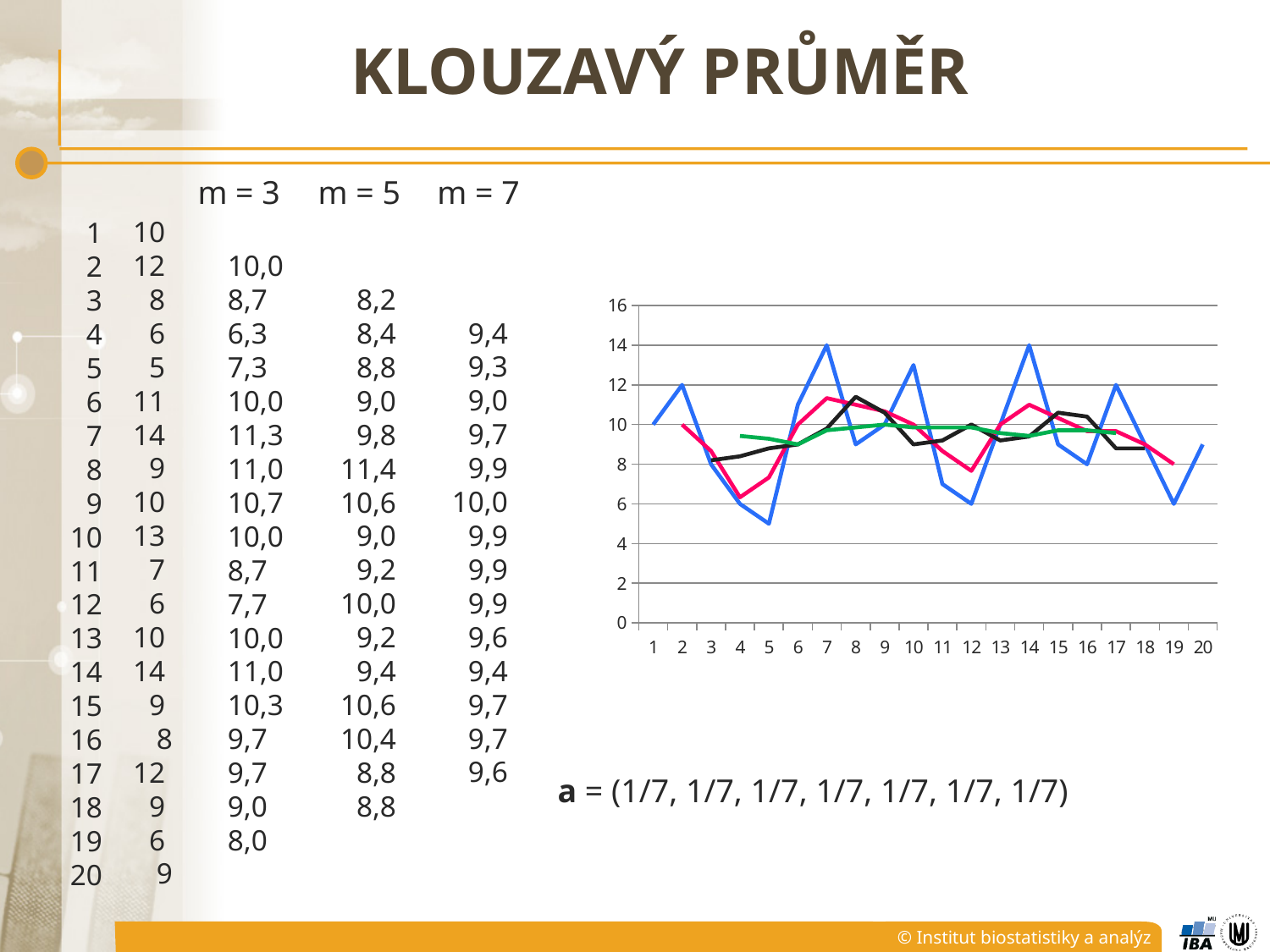
What kind of chart is shown on the slide? line chart What is the value of the blue line at point 12? 6 Does the blue line rise or fall from point 17 to point 19? fall How many lines are plotted on the chart? 4 How many points are labelled along the x axis of the chart? 20 At which x-axis point does the blue line reach its lowest value? 5 Is the value of the blue line at point 14 greater or less than 12? greater What is the value of the blue line at point 7? 14 What colour is the line with the largest swings (the raw data) on the chart? blue Is the value of the blue line at point 10 greater or less than 12? greater Which is larger on the blue line: the value at point 7 or the value at point 8? point 7 Is the value of the blue line at point 5 greater or less than 6? less